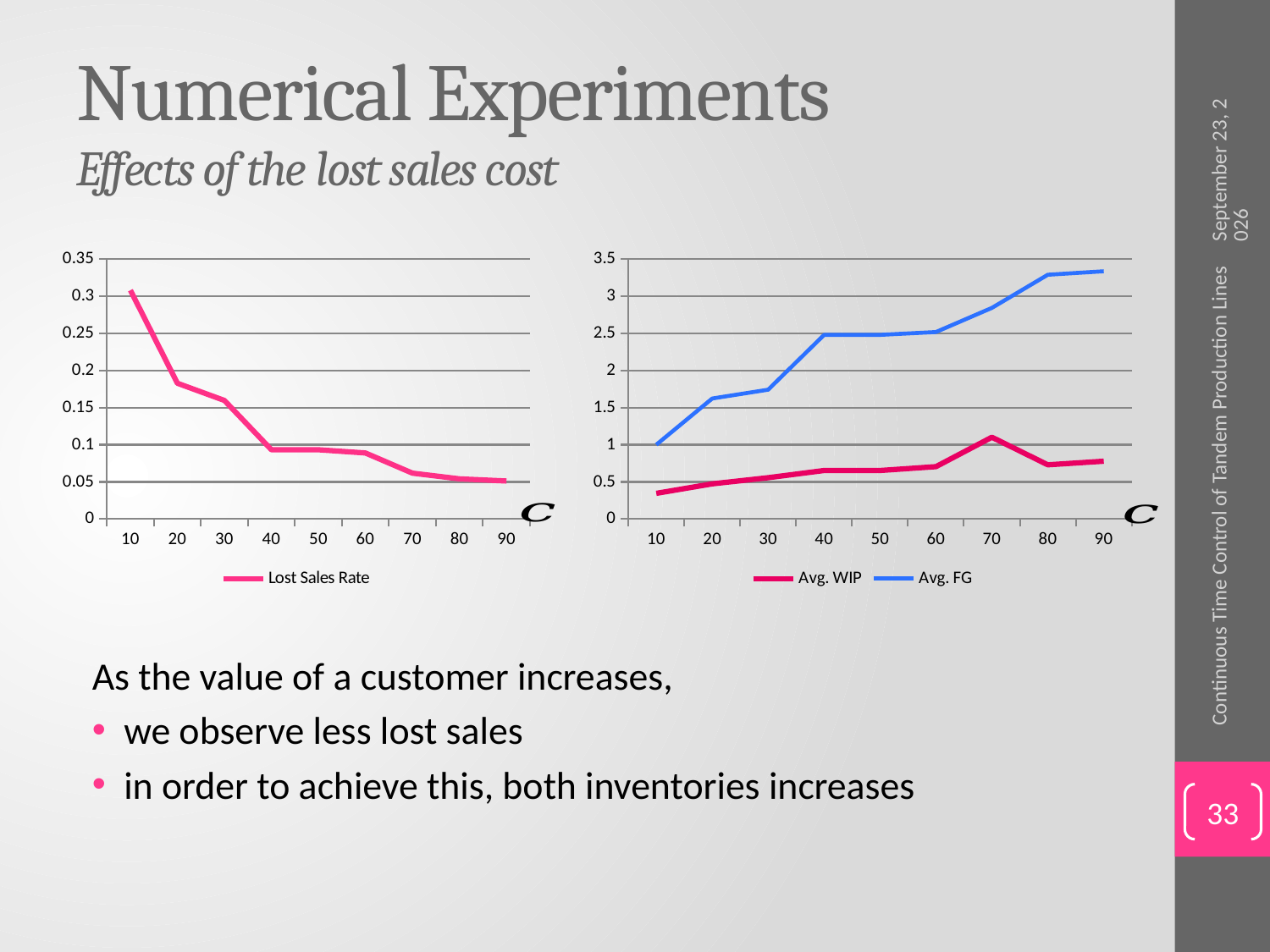
In the right chart, is Avg. FG at C = 40 greater or less than 2? greater In the left chart, is the Lost Sales Rate at C = 10 greater or less than 0.25? greater In the right chart, at which value of C is Avg. WIP highest? 70 What type of chart is the left chart showing the Lost Sales Rate? line chart In the left chart, how many x-axis points are plotted for the Lost Sales Rate? 9 In the left chart, is the Lost Sales Rate at C = 70 greater or less than 0.1? less How many series does the legend of the right chart list? 2 In the left chart, does the Lost Sales Rate rise or fall as C increases from 10 to 90? fall In the right chart, does Avg. FG generally rise or fall as C increases from 10 to 90? rise In the right chart, at C = 50, which series has the larger value, Avg. WIP or Avg. FG? Avg. FG In the right chart, at which value of C is Avg. FG highest? 90 In the left chart, at which value of C is the Lost Sales Rate highest? 10